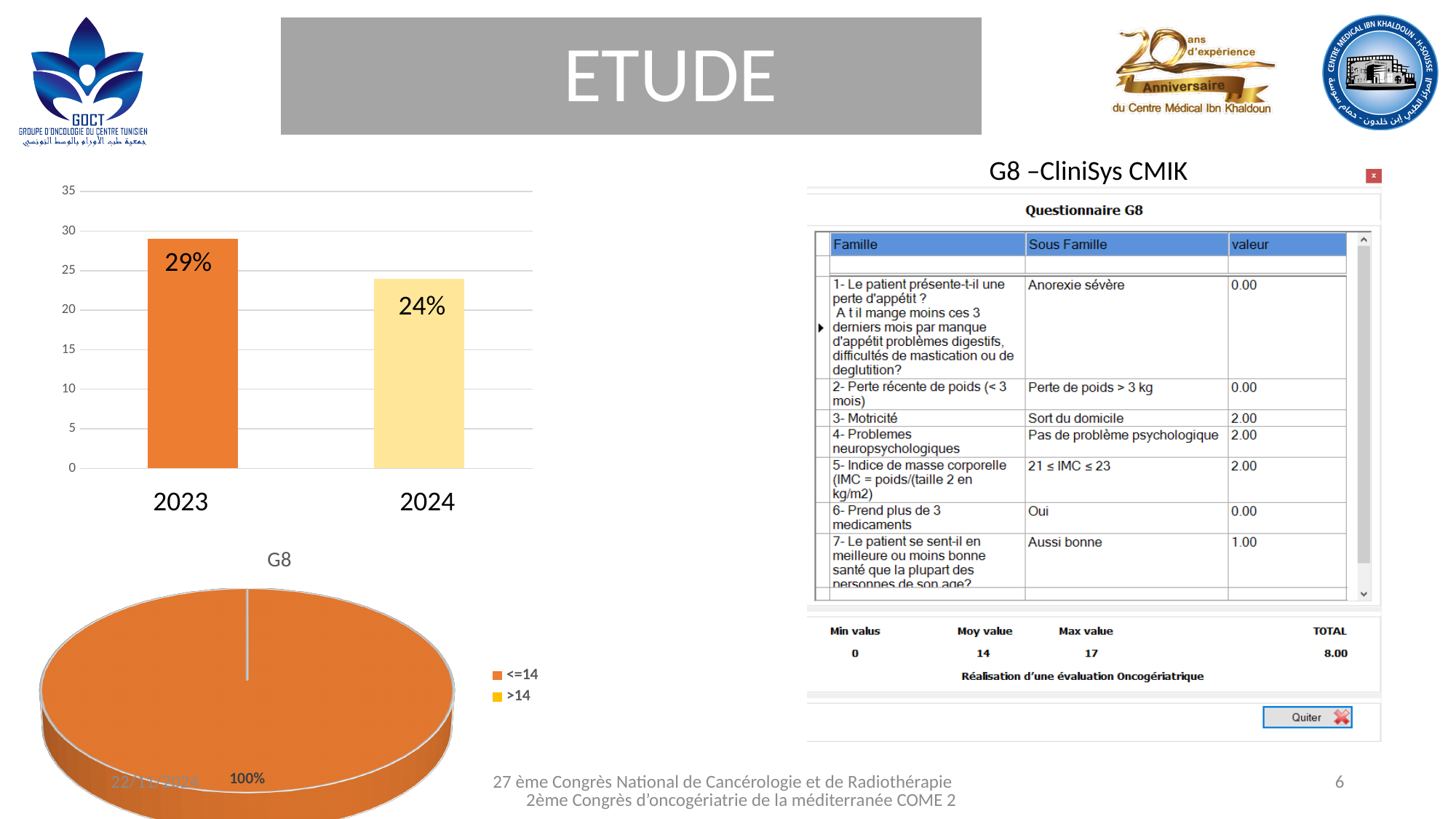
How many entries does the legend of the pie chart titled G8 list? 2 In the bar chart on the left, what is the data label shown for 2024? 24% How many bars are shown in the bar chart on the left? 2 In the pie chart titled G8, what share is shown for the <=14 slice? 100% Do the values in the bar chart on the left rise or fall from 2023 to 2024? fall In the bar chart on the left, which year has the higher bar? 2023 What type of chart is the chart titled G8 at the bottom left? pie chart In the bar chart on the left, what is the data label shown for 2023? 29% In the bar chart on the left, is the bar for 2023 greater or less than 25 on the axis? greater In the bar chart on the left, is the bar for 2024 greater or less than 25 on the axis? less In the bar chart on the left, what is the difference between the labelled values for 2023 and 2024? 5% In the bar chart on the left, which year has the lower bar? 2024